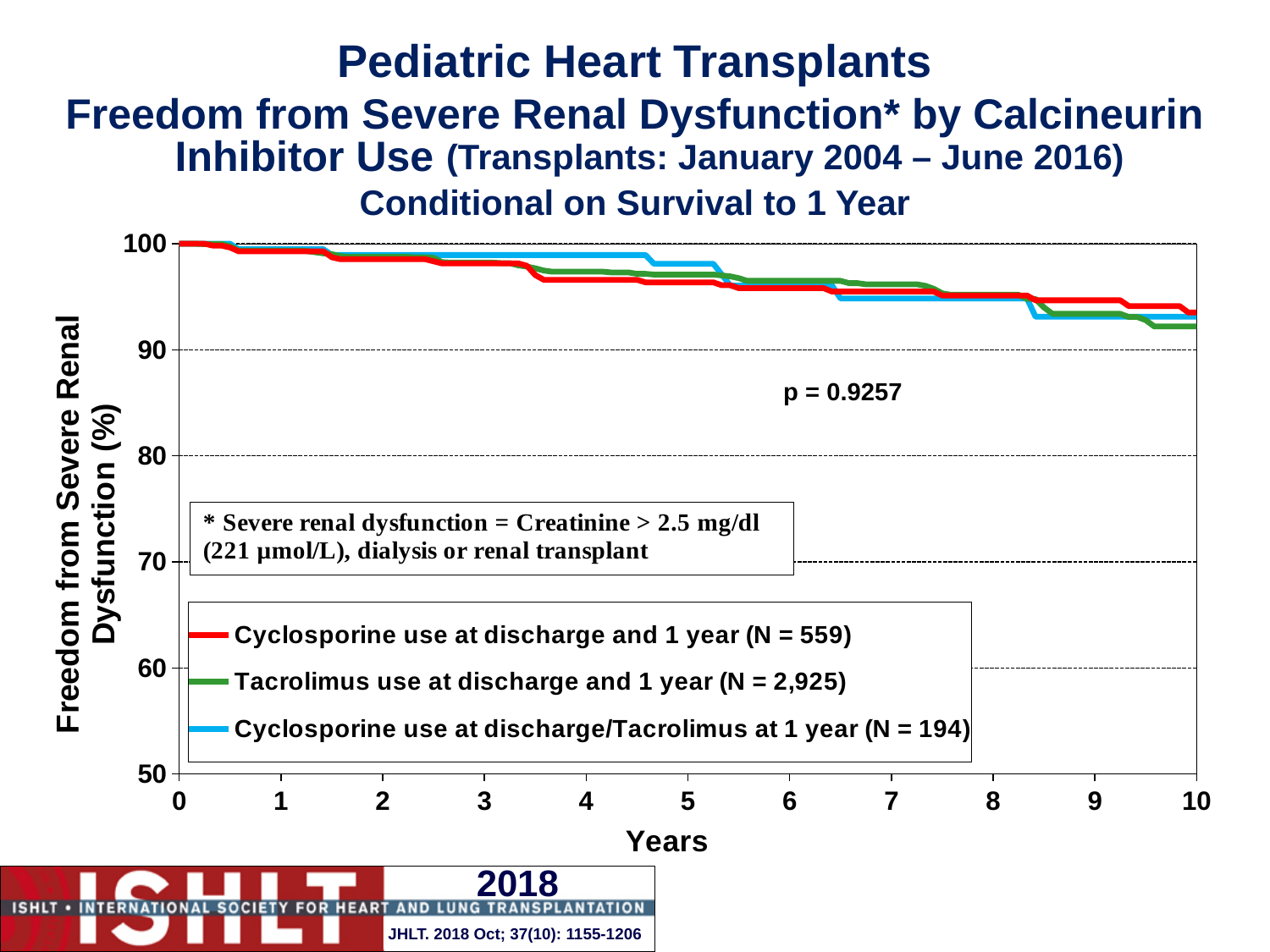
What is the largest number of years shown on the x axis? 10 What is the highest value shown on the y axis? 100 Do the values for Tacrolimus use at discharge and 1 year rise or fall as years increase? fall Do the values for Cyclosporine use at discharge and 1 year rise or fall as years increase? fall Is the value for Tacrolimus use at discharge and 1 year at 10 years greater or less than 90? greater Is the value for Cyclosporine use at discharge and 1 year at 10 years greater or less than 90? greater What kind of chart is shown on the slide? line chart What is the p-value printed on the chart? p = 0.9257 Is the value for Cyclosporine use at discharge/Tacrolimus at 1 year at 10 years greater or less than 90? greater How many series does the legend list? 3